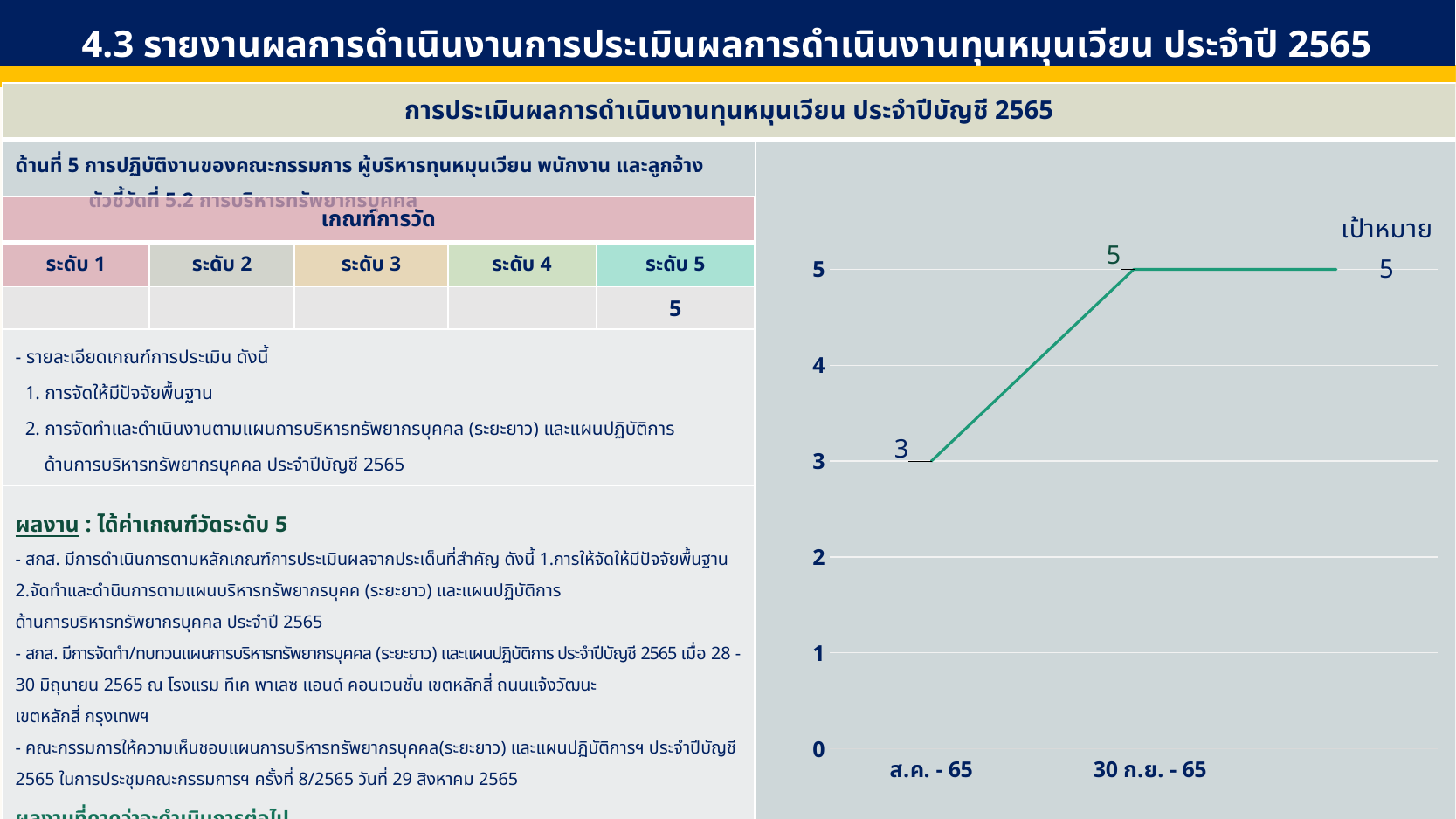
What is the value plotted for ส.ค. - 65? 3 Do the plotted values rise or fall from ส.ค. - 65 to 30 ก.ย. - 65? rise What is the value shown for เป้าหมาย (target) on the chart? 5 Is the value for ส.ค. - 65 greater or less than 4? less Which x-axis category has the lowest plotted value? ส.ค. - 65 What is the value plotted for 30 ก.ย. - 65? 5 How many labelled categories are on the x axis of the chart? 2 Which x-axis category has the higher value, ส.ค. - 65 or 30 ก.ย. - 65? 30 ก.ย. - 65 What kind of chart is shown on the right side of the slide? line chart What is the highest value shown on the y axis of the chart? 5 What is the difference between the value for 30 ก.ย. - 65 and the value for ส.ค. - 65? 2 Does the value for 30 ก.ย. - 65 equal the เป้าหมาย (target) value? yes